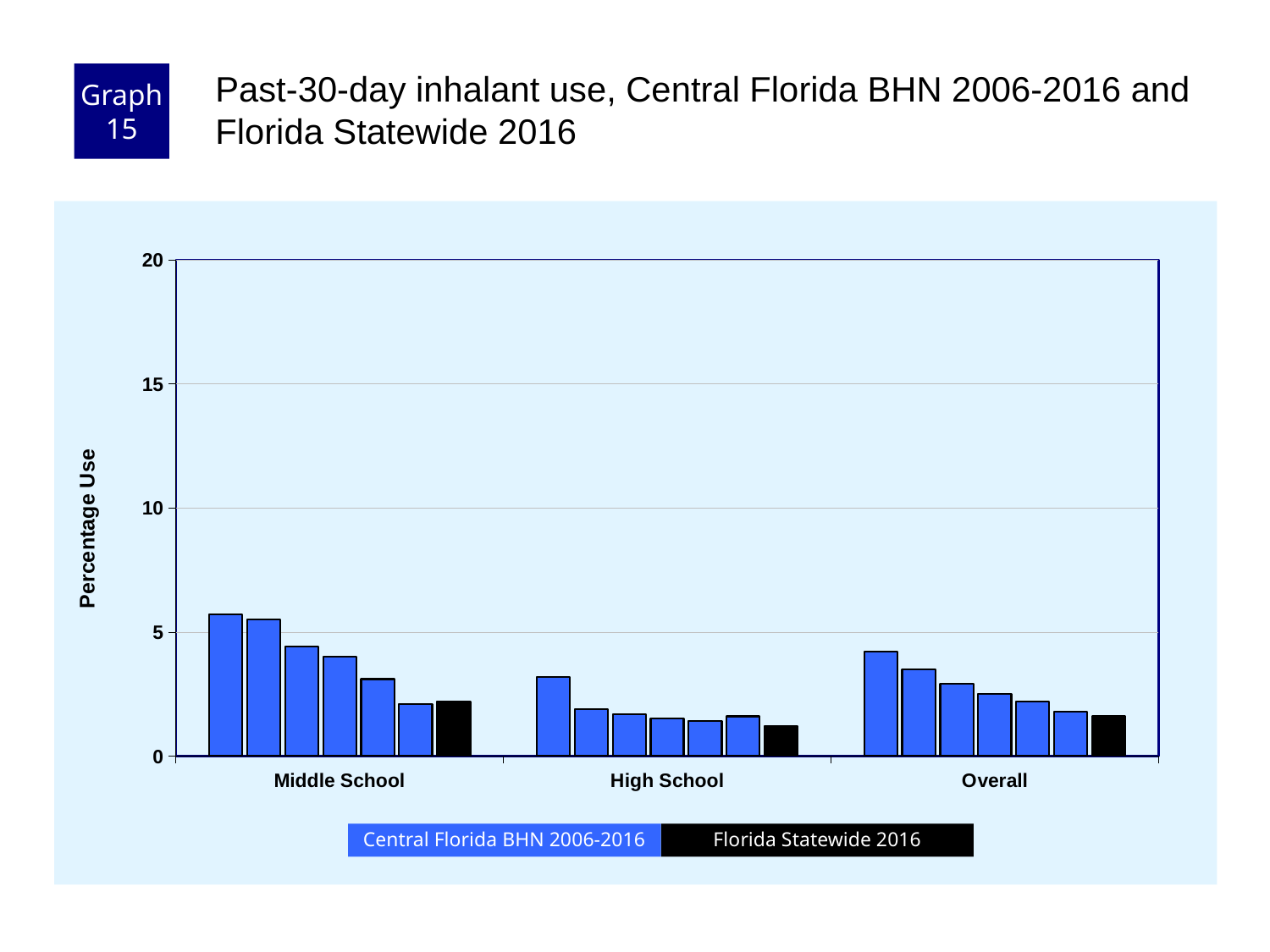
Which is larger: the first Central Florida BHN bar for Middle School or the first Central Florida BHN bar for High School? Middle School How many entries does the legend list? 2 What kind of chart is shown on the slide? bar chart Is the tallest Middle School bar greater or less than 5? greater Is the Florida Statewide 2016 value for High School greater or less than 5? less Is the tallest Overall bar greater or less than 5? less Do the Central Florida BHN bars for Middle School rise or fall from left to right? fall Which category has the tallest bar overall: Middle School, High School, or Overall? Middle School What is the label of the y axis? Percentage Use Which colour represents Florida Statewide 2016 in the legend? black How many school-level categories are shown on the x axis? 3